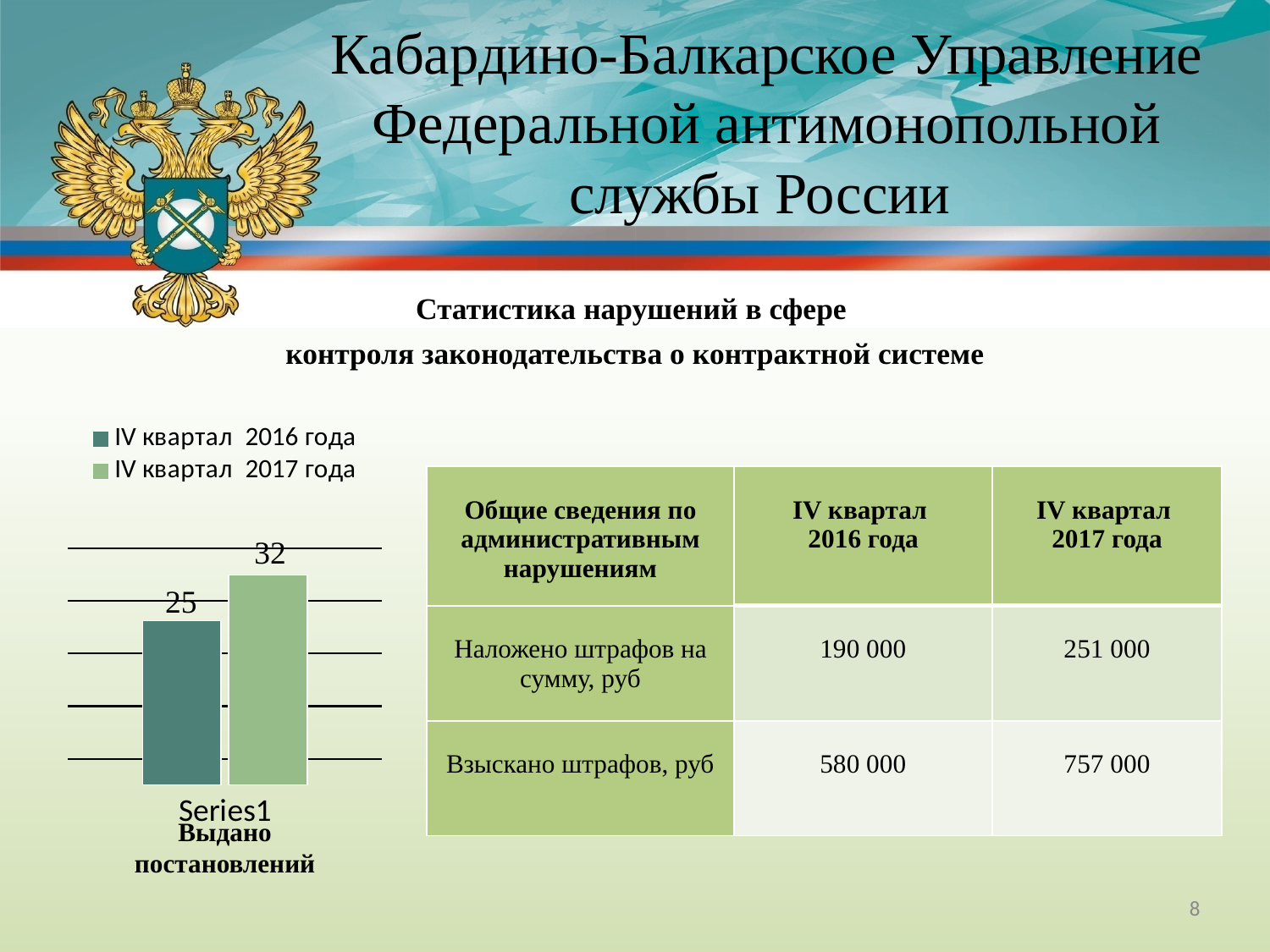
What is the difference between the values for IV квартал 2017 года and IV квартал 2016 года in the chart? 7 What is the value for IV квартал 2017 года in the chart? 32 What is the category label shown on the x axis of the chart? Series1 Which series has the higher value in the chart, IV квартал 2016 года or IV квартал 2017 года? IV квартал 2017 года Which series has the lowest value in the chart? IV квартал 2016 года How many series does the chart legend list? 2 How many categories are shown on the x axis of the chart? 1 What is the caption written below the chart? Выдано постановлений What kind of chart is shown on the slide? bar chart What is the value for IV квартал 2016 года in the chart? 25 Which series has the highest value in the chart? IV квартал 2017 года